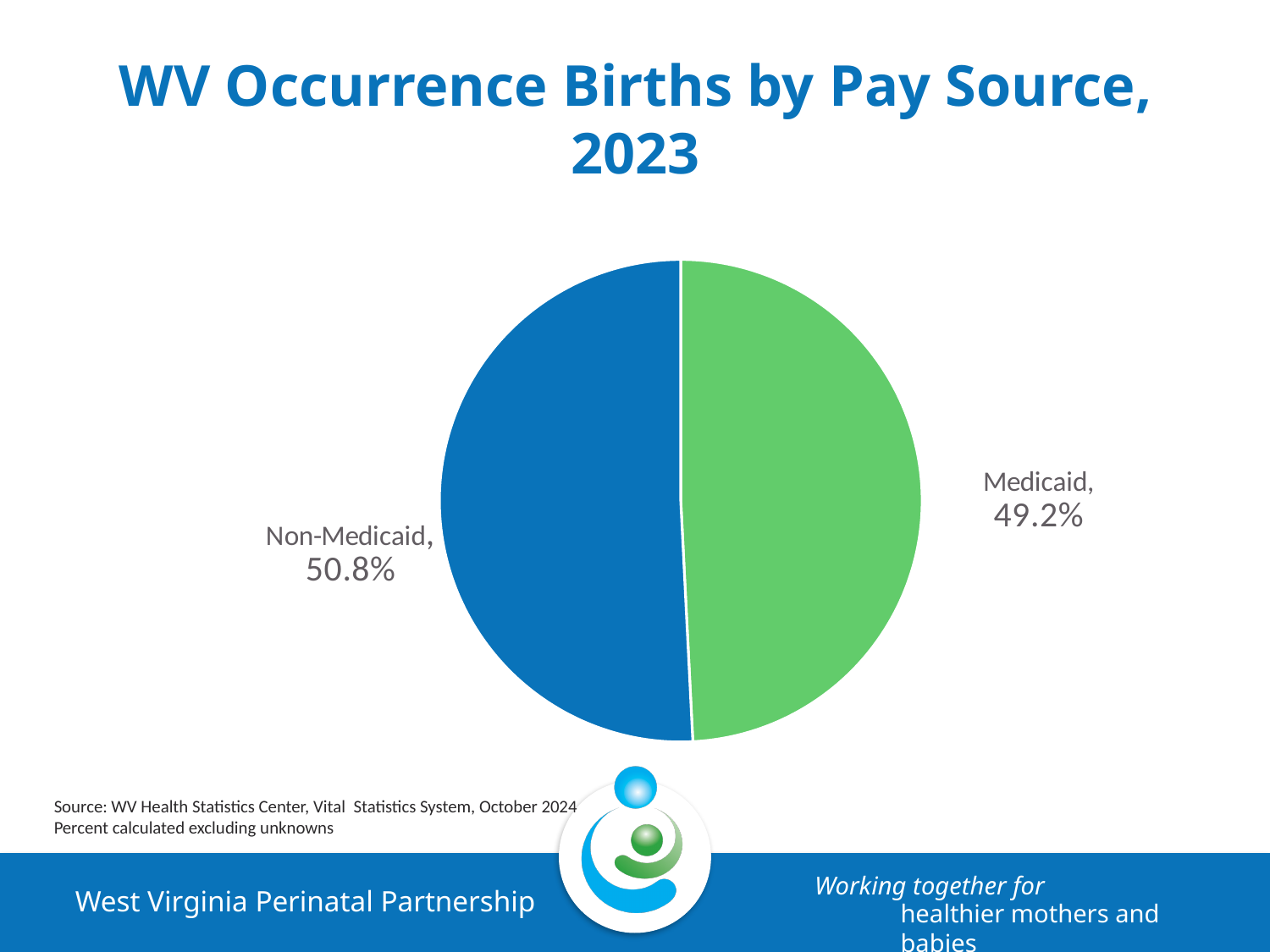
What colour is the Medicaid slice of the pie chart? green What percentage of WV occurrence births in 2023 were paid by Medicaid? 49.2% Which pay source has the smaller share of births in the pie chart? Medicaid What type of chart is shown on the slide? pie chart How many slices does the pie chart have? 2 What is the title of the chart? WV Occurrence Births by Pay Source, 2023 Is the Medicaid share larger or smaller than the Non-Medicaid share? smaller What is the difference in percentage points between the Non-Medicaid and Medicaid shares? 1.6 Which pay source has the larger share of births in the pie chart? Non-Medicaid What percentage of WV occurrence births in 2023 were Non-Medicaid? 50.8% What share of the pie does the Medicaid slice represent? 49.2%